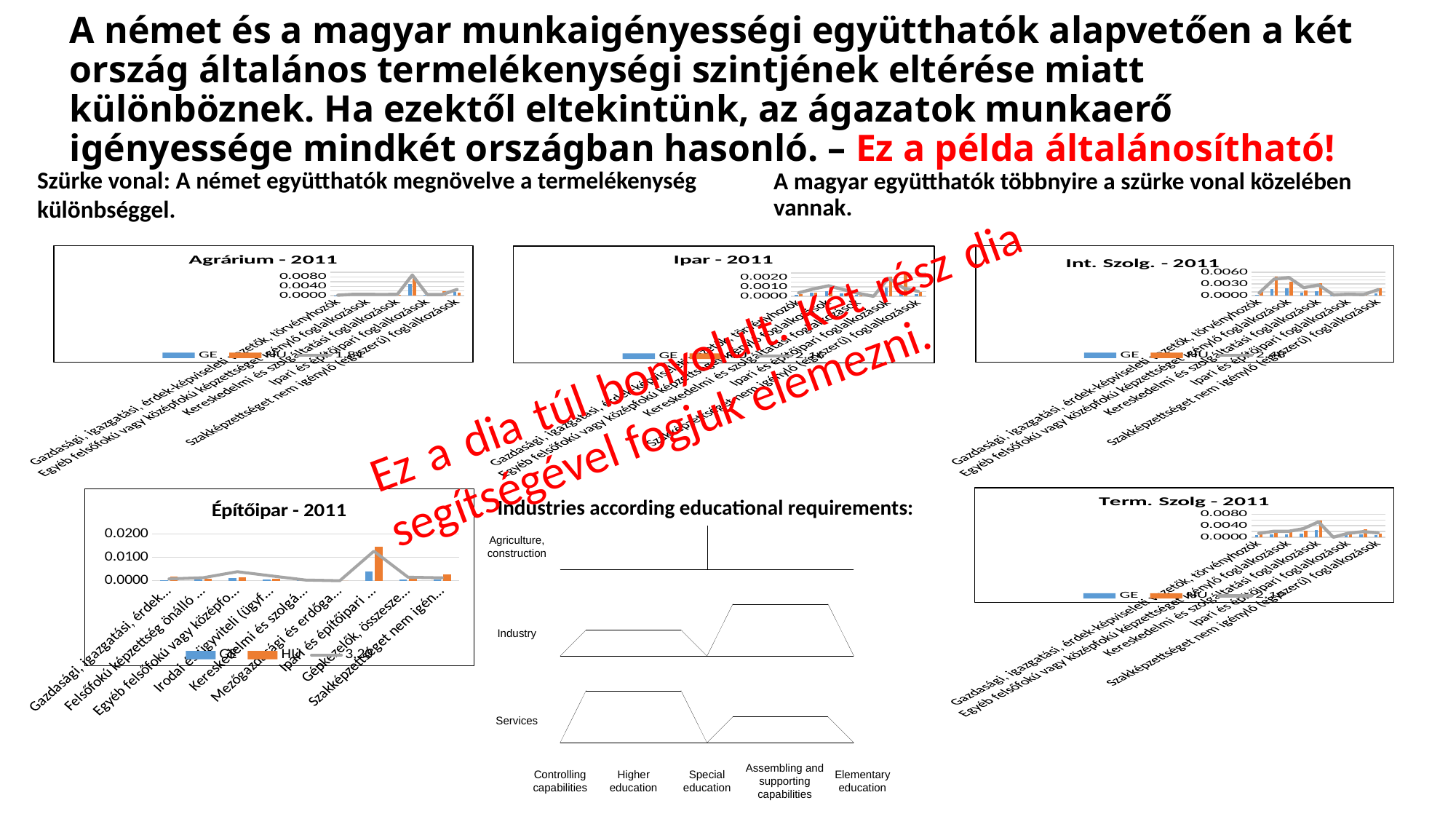
What is the highest value shown on the vertical axis of the 'Ipar - 2011' chart? 0.0020 What kind of chart is the 'Építőipar - 2011' chart? bar chart with a line In the 'Építőipar - 2011' chart, which series has the tallest bar, GE or HU? HU What is the title of the chart in the top-left corner of the slide? Agrárium - 2011 How many series does the legend of the 'Építőipar - 2011' chart list? 3 What is the highest value shown on the vertical axis of the 'Építőipar - 2011' chart? 0.0200 How many series does the legend of the 'Agrárium - 2011' chart list? 3 In the 'Építőipar - 2011' chart, is the tallest orange (HU) bar greater or less than 0.0100? greater How many categories are shown on the x axis of the 'Építőipar - 2011' chart? 9